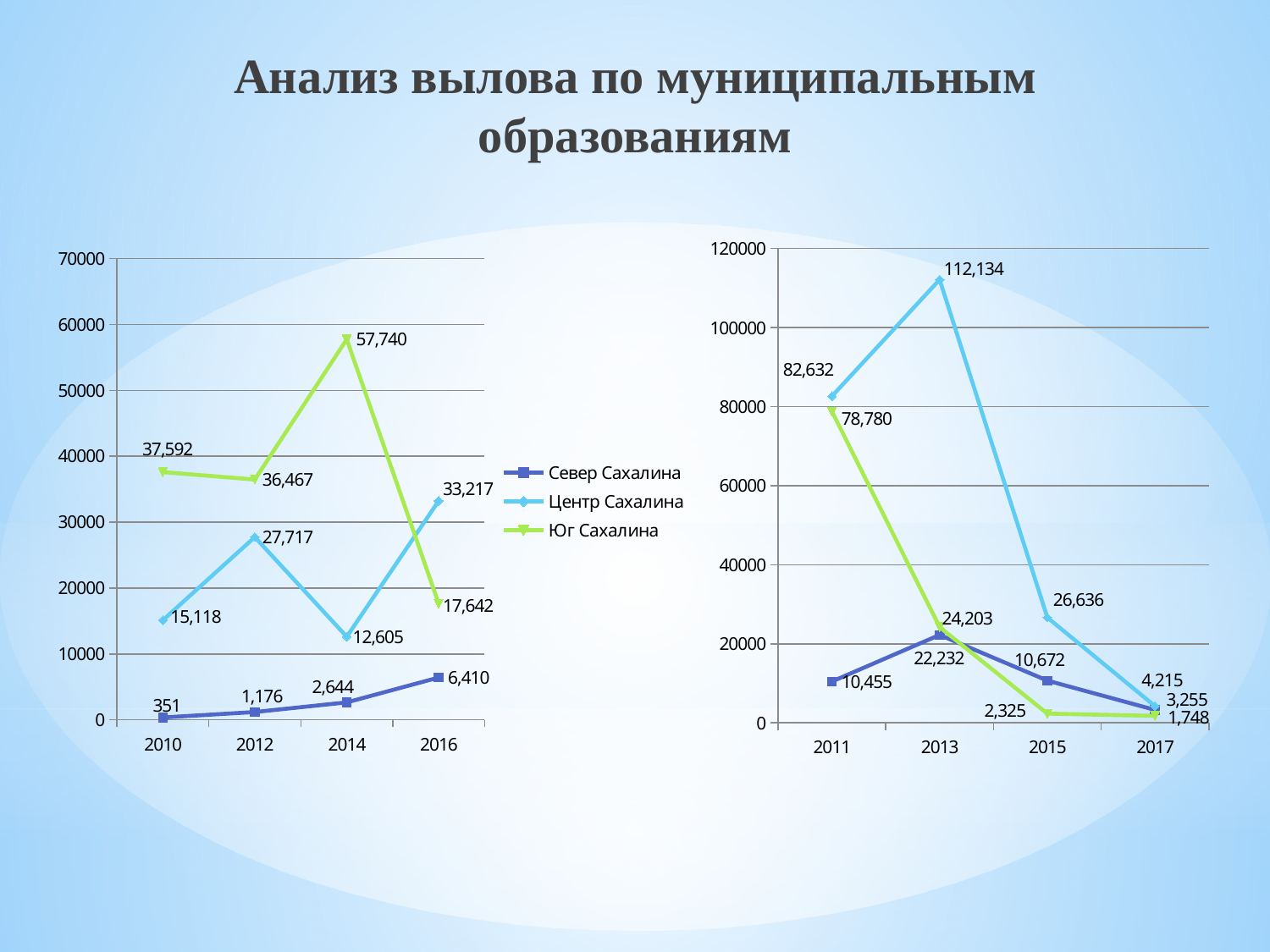
On the left chart, in which year is the value for Север Сахалина lowest? 2010 On the left chart, in which year does Юг Сахалина reach its highest value? 2014 How many series does the legend on the left chart list? 3 On the left chart, which is larger in 2016: Центр Сахалина or Юг Сахалина? Центр Сахалина On the left chart, what is the value for Центр Сахалина in 2012? 27,717 On the right chart, what is the highest value shown for the light blue line (Центр Сахалина)? 112,134 On the left chart, what is the difference between Юг Сахалина and Центр Сахалина in 2010? 22,474 On the left chart, what is the value for Юг Сахалина in 2014? 57,740 On the left chart, what is the value for Север Сахалина in 2016? 6,410 On the right chart, what is the value for the green line (Юг Сахалина) in 2017? 1,748 What kind of chart is the right chart? line chart On the left chart, does the value for Север Сахалина rise or fall from 2010 to 2016? rise